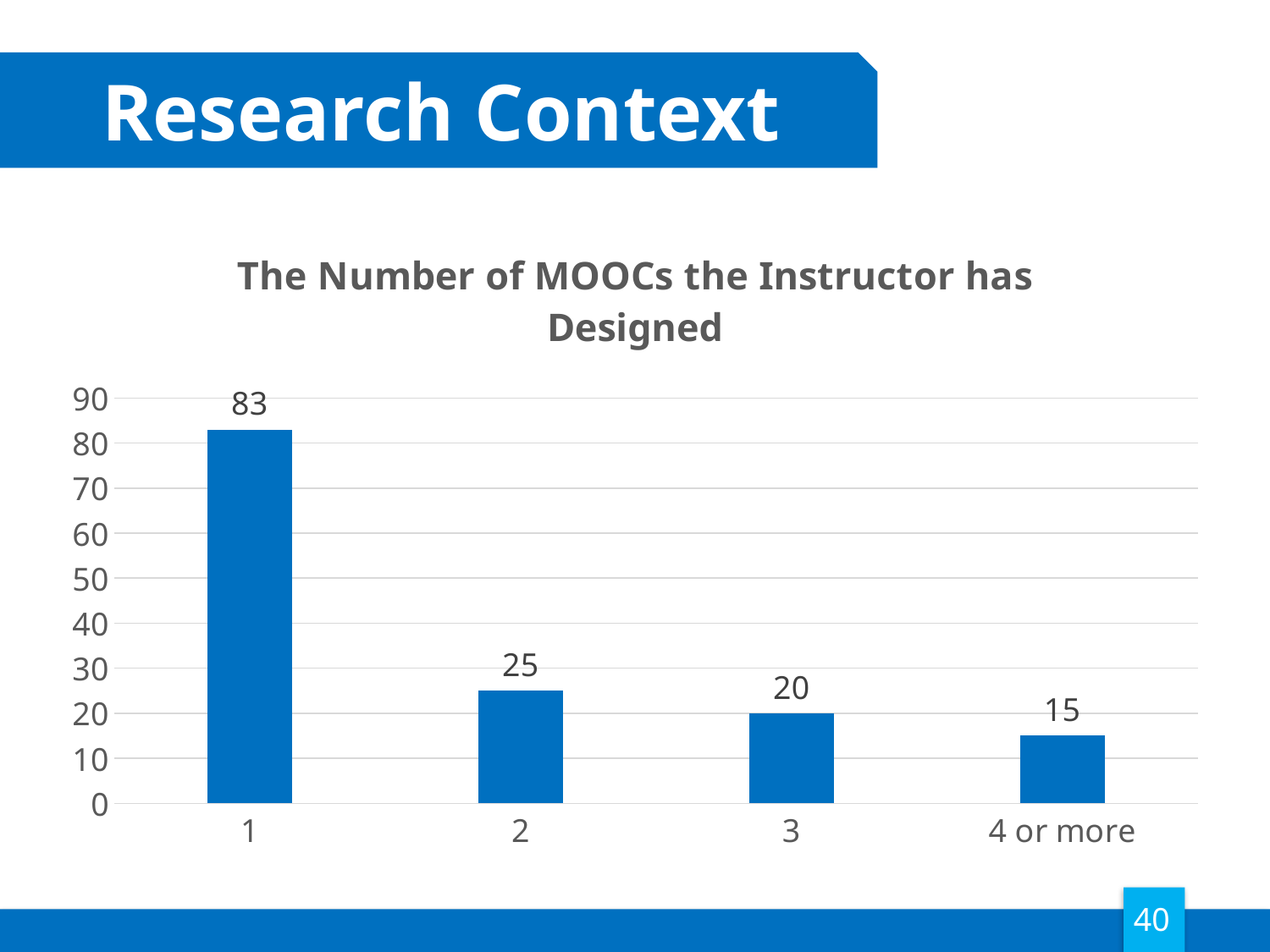
What is the value for the category "4 or more"? 15 Which is larger, the value for "2" or the value for "3"? 2 What is the title of the chart? The Number of MOOCs the Instructor has Designed What is the difference between the values for "1" and "2"? 58 Which category has the lowest value? 4 or more Which category has the highest value? 1 How many categories are shown on the x axis? 4 What kind of chart is shown on the slide? bar chart What is the value for the category "3"? 20 Is the value for "2" greater or less than 30? less What is the value for the category "1"? 83 What is the difference between the values for "3" and "4 or more"? 5